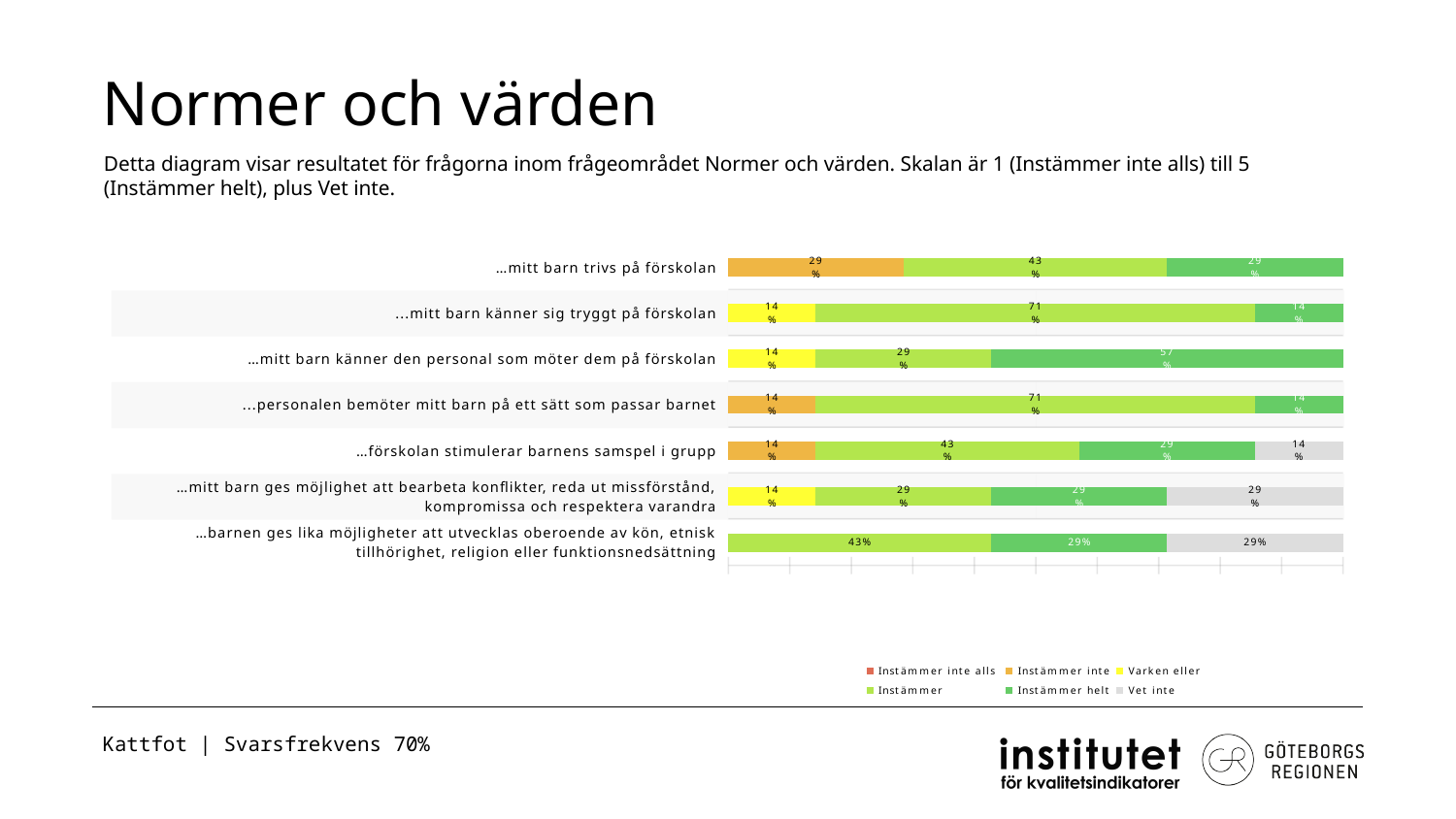
How many series does the legend list? 6 How many statements (categories) are plotted in the chart? 7 What is the title of the slide containing the chart? Normer och värden What is the 'Instämmer helt' value for '…mitt barn känner den personal som möter dem på förskolan'? 57% What kind of chart is shown on the slide? Stacked bar chart What is the 'Instämmer' value for '…förskolan stimulerar barnens samspel i grupp'? 43% What is the 'Instämmer' value for '…mitt barn känner sig tryggt på förskolan'? 71% What is the difference between the 'Instämmer' value and the 'Instämmer helt' value for '…mitt barn trivs på förskolan'? 14% Which statement has the highest 'Instämmer helt' value? …mitt barn känner den personal som möter dem på förskolan What is the 'Vet inte' value for '…barnen ges lika möjligheter att utvecklas oberoende av kön, etnisk tillhörighet, religion eller funktionsnedsättning'? 29% What is the 'Vet inte' value for '…förskolan stimulerar barnens samspel i grupp'? 14% Which is larger for '…mitt barn känner den personal som möter dem på förskolan': the 'Instämmer' value or the 'Instämmer helt' value? Instämmer helt